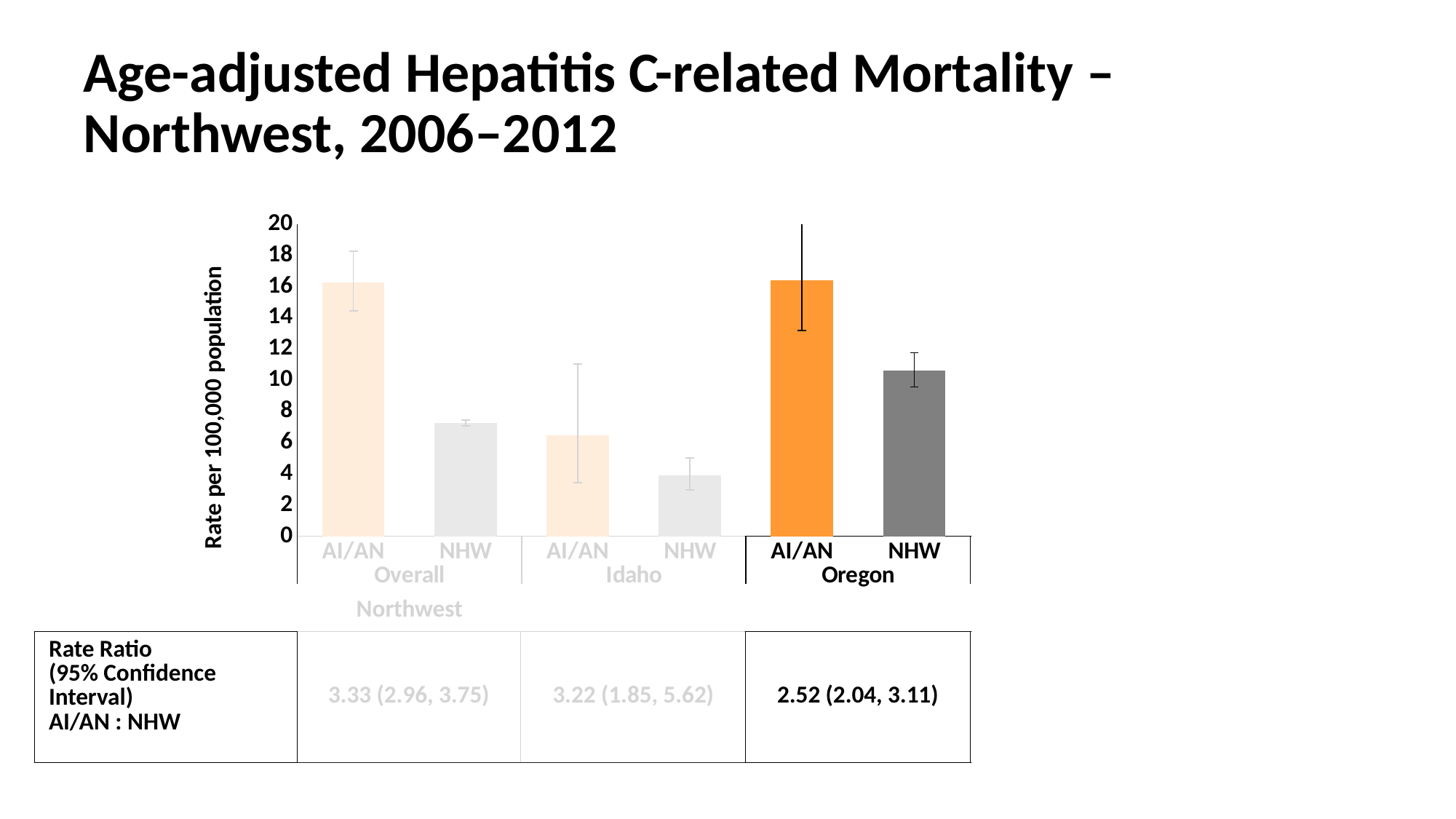
How many bars are plotted in the chart? 6 Is the value for Oregon AI/AN greater or less than 14? greater Which bar has the lowest value in the chart? Idaho NHW In the Oregon group, which is larger, the AI/AN bar or the NHW bar? AI/AN Is the value for Idaho AI/AN greater or less than 8? less Is the value for Oregon NHW greater or less than 8? greater What is the label of the y axis of the chart? Rate per 100,000 population What kind of chart is shown on the slide? bar chart What is the rate ratio (95% confidence interval) for AI/AN : NHW in Oregon shown in the table below the chart? 2.52 (2.04, 3.11) How many regional groups are shown along the x axis of the chart? 3